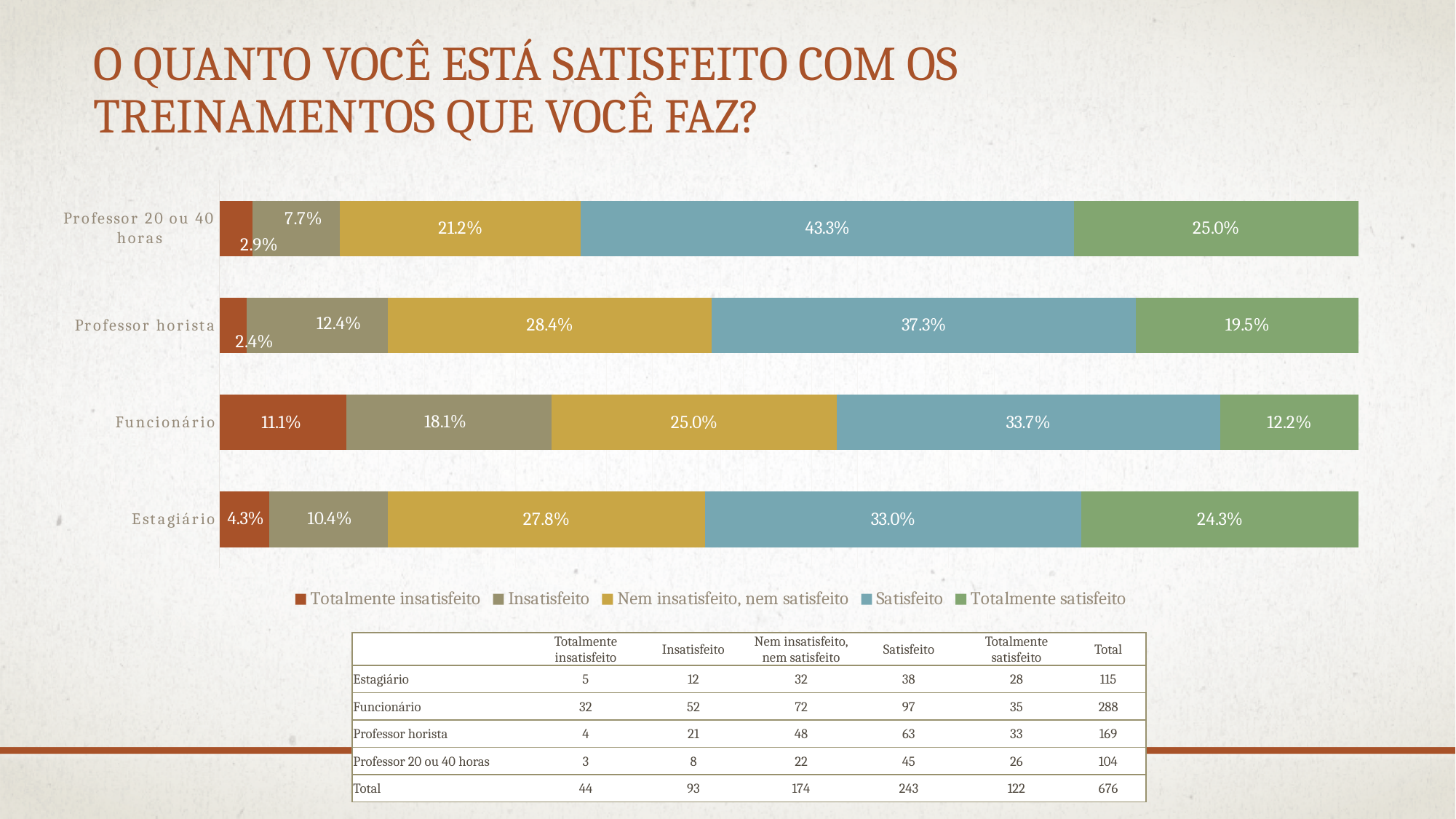
Which category has the highest Totalmente insatisfeito percentage? Funcionário What kind of chart is shown on the slide? Stacked bar chart What is the difference between the Totalmente satisfeito values for Professor 20 ou 40 horas and Estagiário? 0.7 percentage points How many series does the legend list? 5 Which category has the lowest Totalmente satisfeito percentage? Funcionário What colour represents the Satisfeito series in the chart? Blue How many categories (bars) are shown in the chart? 4 What is the Insatisfeito value for Estagiário? 10.4% Which category has the highest Satisfeito percentage? Professor 20 ou 40 horas What is the Totalmente insatisfeito value for Funcionário? 11.1% Which is larger: the Nem insatisfeito, nem satisfeito value for Professor horista or for Estagiário? Professor horista What percentage of Professor horista respondents answered Satisfeito? 37.3%